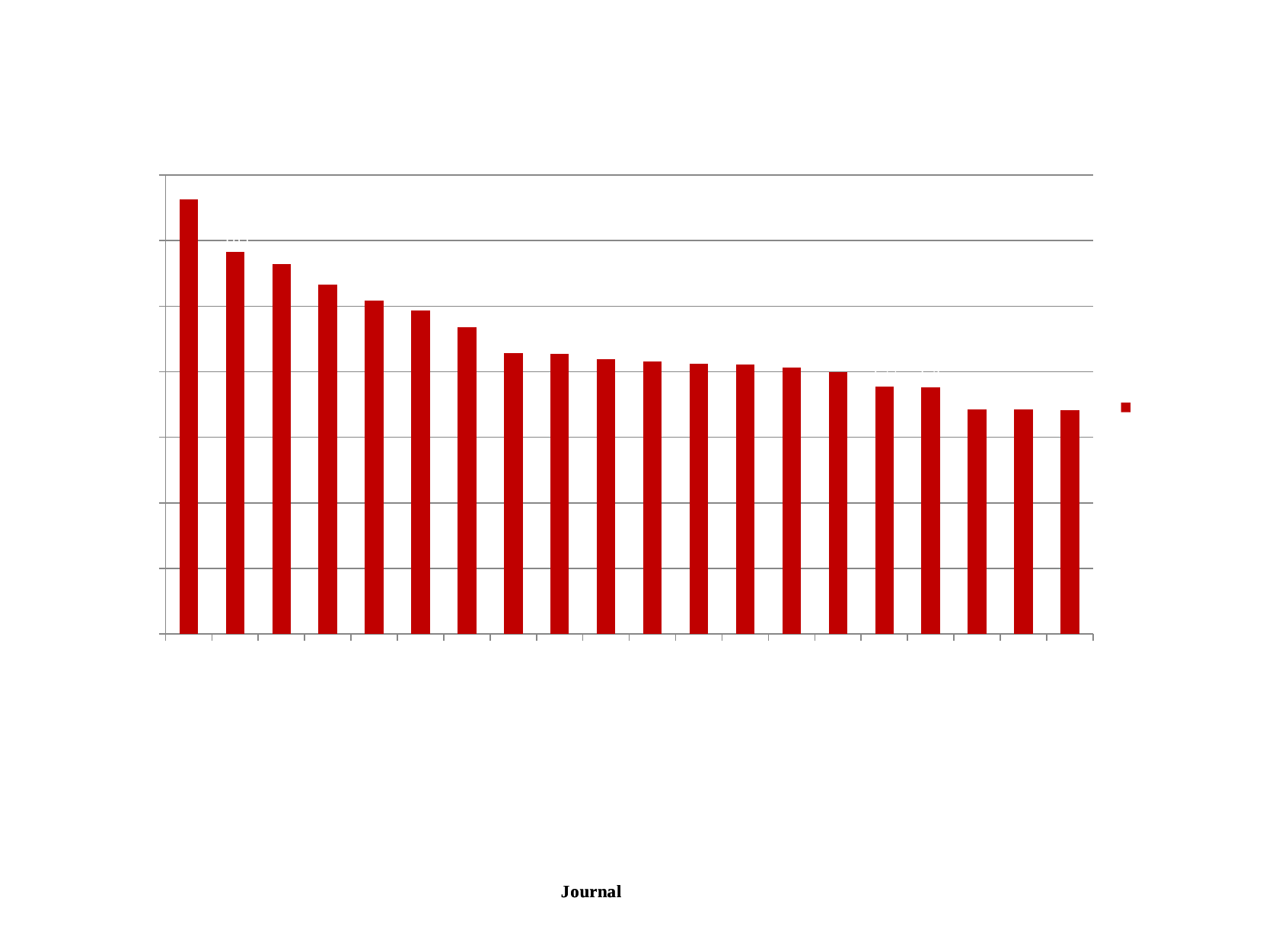
What is the title of the x axis? Journal Do the bar values rise or fall from left to right along the x axis? fall What kind of chart is shown on the slide? bar chart Which bar is taller, the leftmost bar or the rightmost bar? leftmost How many bars are plotted in the chart? 20 How many series does the legend list? 1 Which bar is the tallest in the chart, by position? the leftmost bar What colour are the bars in the chart? red